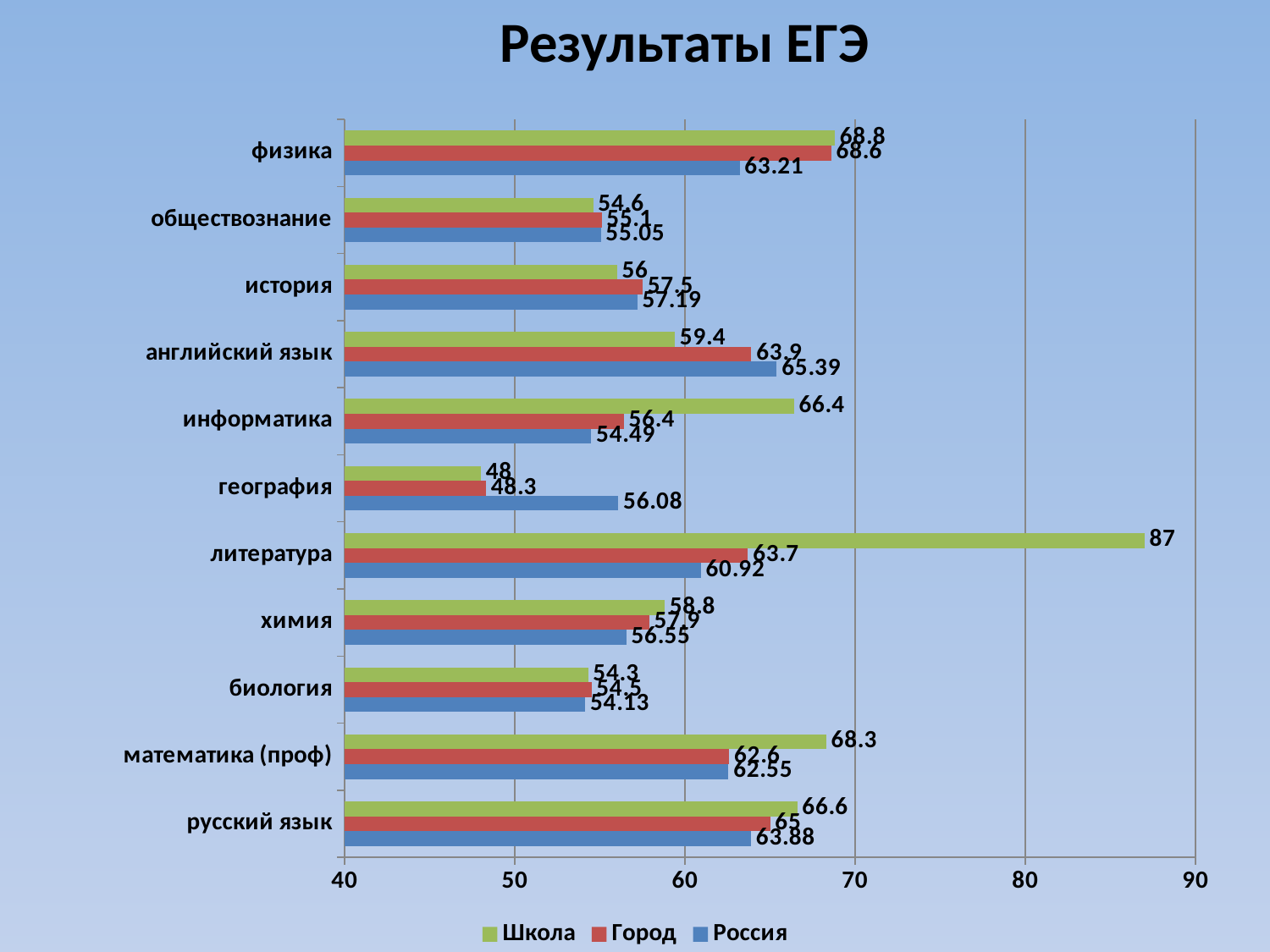
What type of chart is shown on the slide? bar chart Which subject has the highest Школа value? литература What is the Россия value for английский язык? 65.39 How many subjects (categories) are shown on the chart? 11 Which subject has the lowest Школа value? география For география, which is larger: the Город value or the Россия value? Россия What is the title of the chart? Результаты ЕГЭ What is the difference between the Школа and Россия values for информатика? 11.91 What is the Школа value for литература? 87 How many series does the legend list? 3 Is the Школа value for математика (проф) greater or less than 60? greater What is the Город value for информатика? 56.4